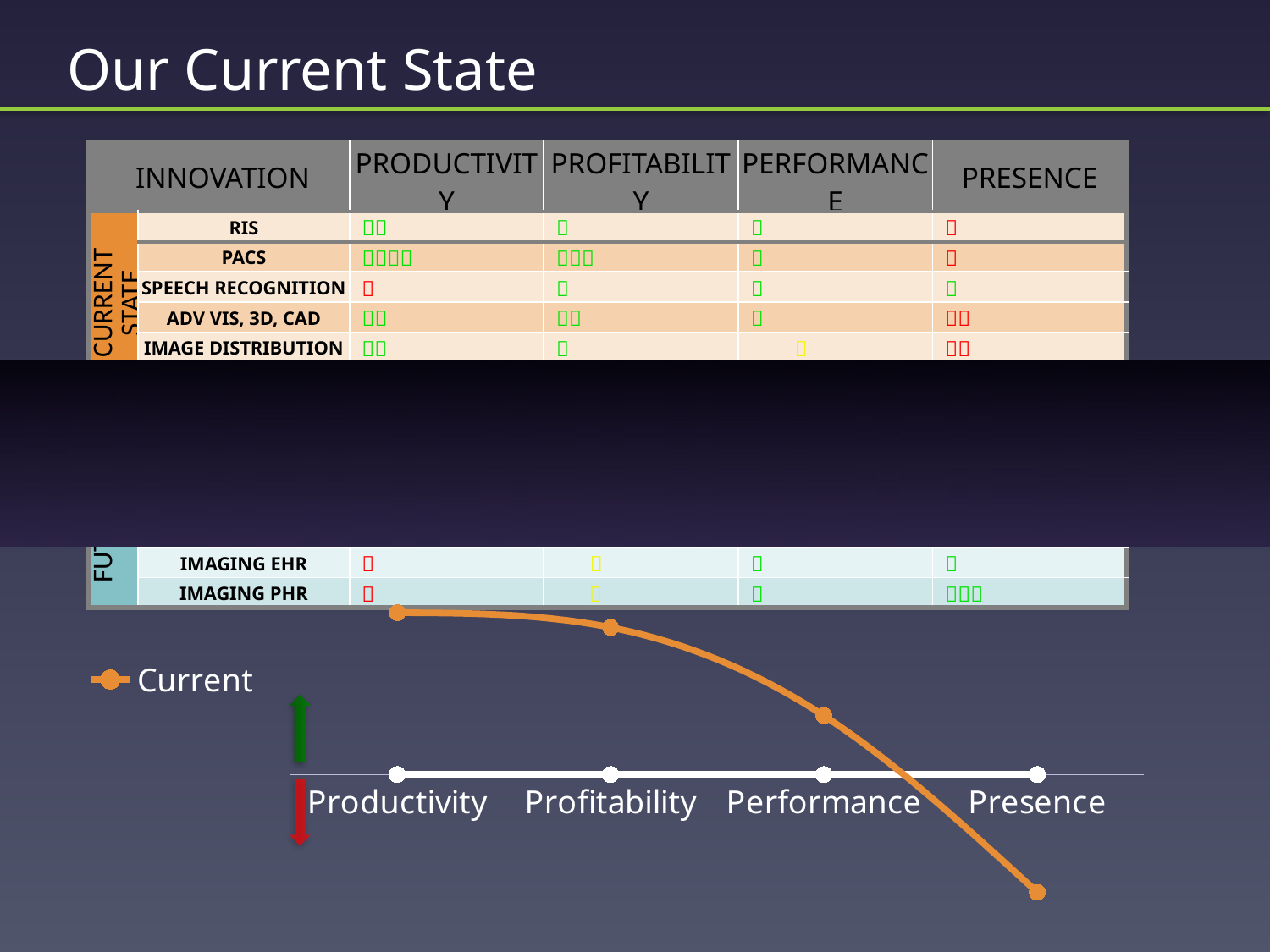
What is the label of the third category on the x axis of the line chart? Performance Do the values of the Current line rise or fall from Productivity to Presence? fall What is the name of the series shown in the legend of the line chart? Current How many categories are plotted along the x axis of the line chart? 4 Which category has the lowest value on the Current line? Presence How many series does the legend of the line chart list? 1 On the Current line, which is larger: the value for Profitability or the value for Performance? Profitability What kind of chart is shown at the bottom of the slide? line chart Which category has the highest value on the Current line? Productivity On the Current line, which is larger: the value for Productivity or the value for Presence? Productivity On the Current line, which is larger: the value for Performance or the value for Presence? Performance